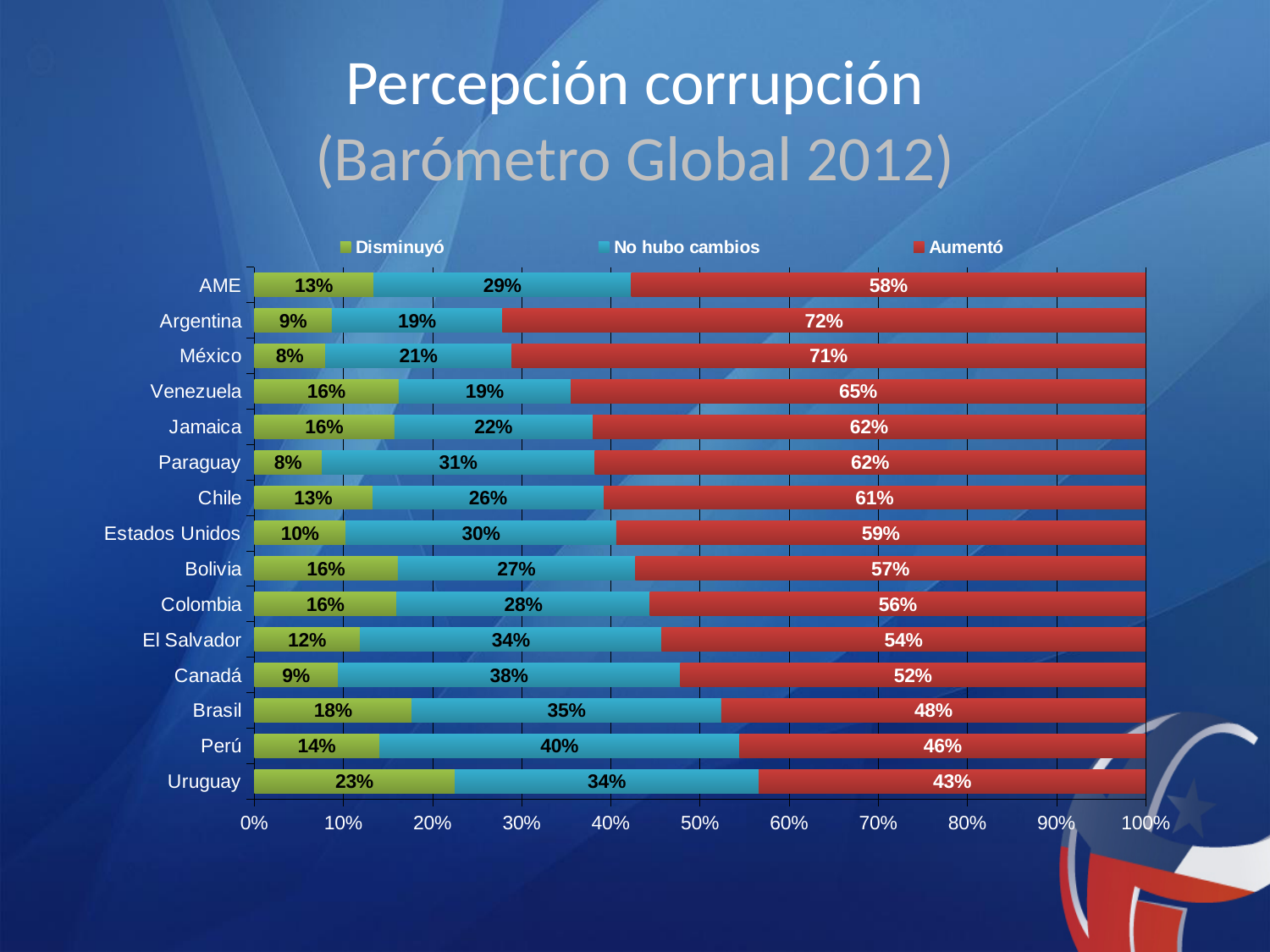
What is the value of "No hubo cambios" for Perú? 40% How many series does the legend list? 3 What kind of chart is shown on the slide? Stacked bar chart What is the difference between the "Aumentó" values for México and Brasil? 23% How many categories are shown on the y axis? 15 Which country has the highest "Aumentó" value? Argentina What is the value of "Disminuyó" for Uruguay? 23% Which is larger, the "No hubo cambios" value for Canadá or for Chile? Canadá What is the total of the stacked bar for Paraguay? 101% Which series is shown in red in the legend? Aumentó What is the value of "Aumentó" for Argentina? 72% Which category has the lowest "Aumentó" value? Uruguay